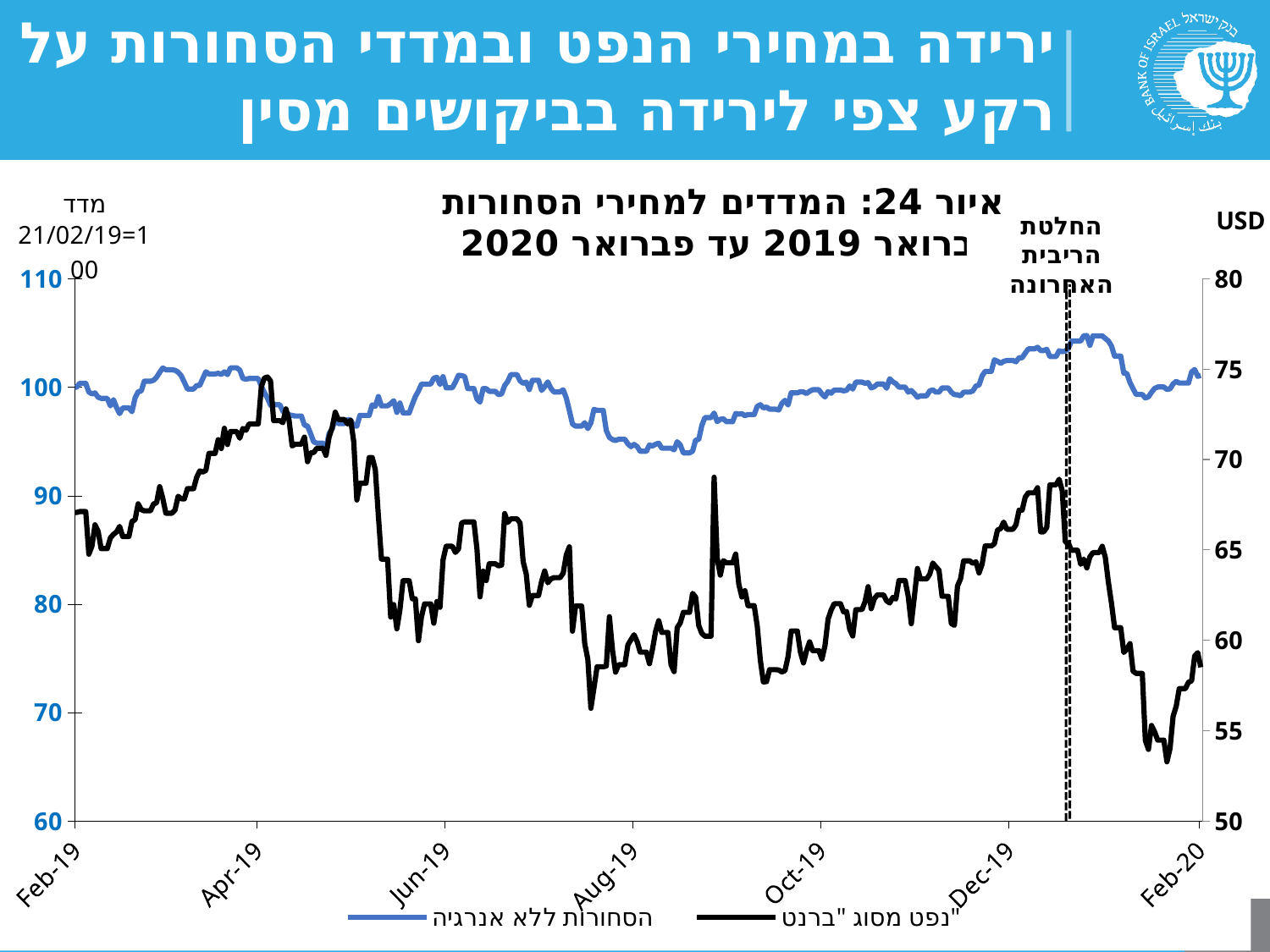
How many date labels are shown along the x axis? 7 Is the value of the Brent oil series at Feb-20 greater or less than 60 USD? less Is the value of the non-energy commodities index at Aug-19 greater or less than 100? less How many series does the legend list? 2 Is the lowest point of the Brent oil series greater or less than 55 USD? less What kind of chart is shown on the slide? line chart Does the non-energy commodities index rise or fall between Jun-19 and Aug-19? fall What unit is shown on the right-hand axis? USD Which series is drawn in black? נפט מסוג "ברנט" Does the Brent oil series rise or fall between Dec-19 and Feb-20? fall